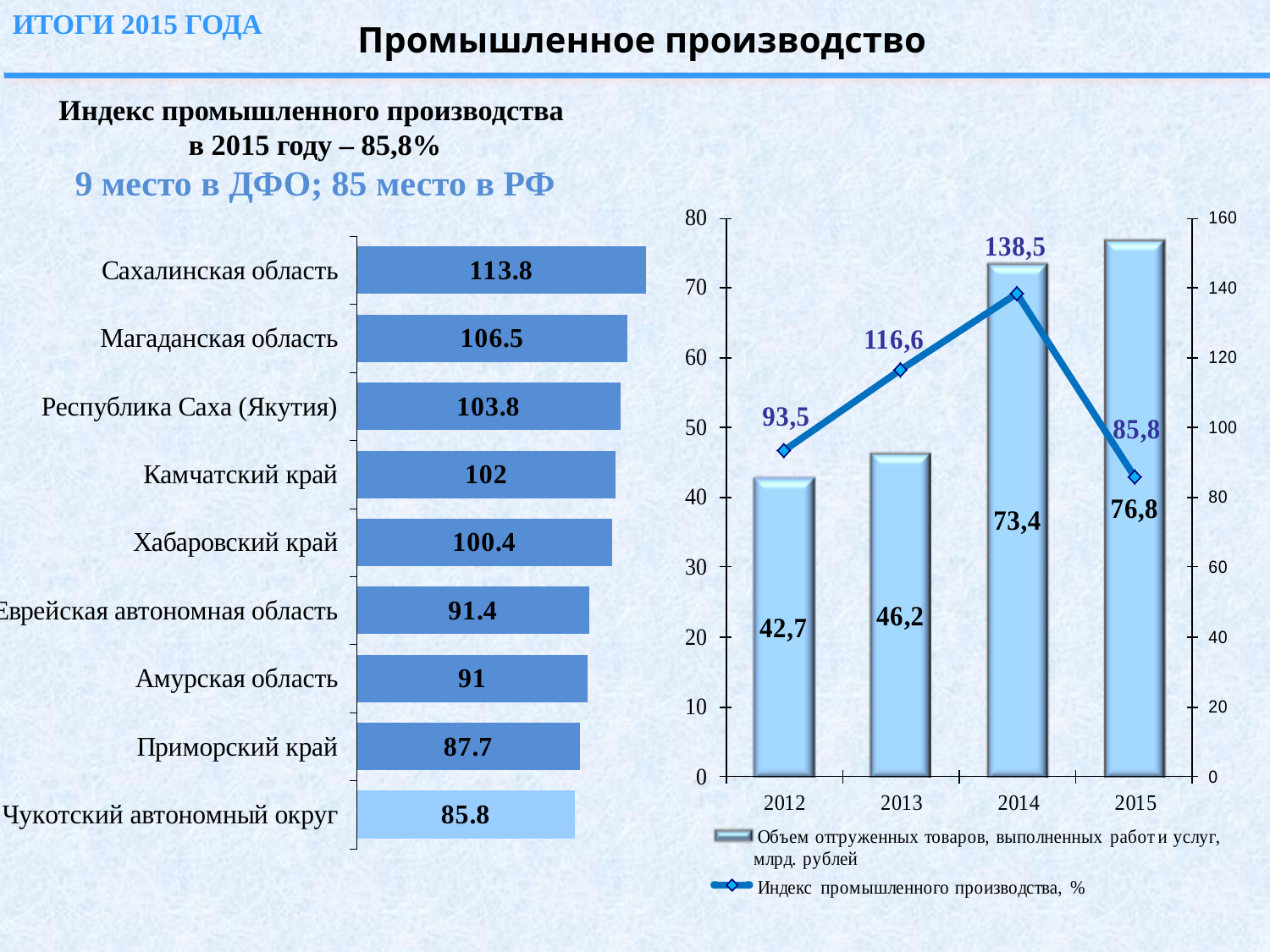
In the left bar chart of regions, which is larger: the value for Хабаровский край or the value for Приморский край? Хабаровский край In the right chart, how many series does the legend list? 2 In the left bar chart of regions, how many regions are shown? 9 In the right chart, what is the value of Индекс промышленного производства for 2013? 116,6 In the right chart, do the values of Объем отгруженных товаров, выполненных работ и услуг rise or fall from 2012 to 2015? rise What kind of chart is the left chart of regions? bar chart In the right chart, which year has the highest value of Индекс промышленного производства? 2014 In the left bar chart of regions, which region has the lowest value? Чукотский автономный округ In the left bar chart of regions, what is the difference between the values for Сахалинская область and Чукотский автономный округ? 28 In the right chart, what is the value of Объем отгруженных товаров, выполненных работ и услуг for 2014? 73,4 In the left bar chart of regions, which region has the highest value? Сахалинская область In the left bar chart of regions, what is the value for Магаданская область? 106.5